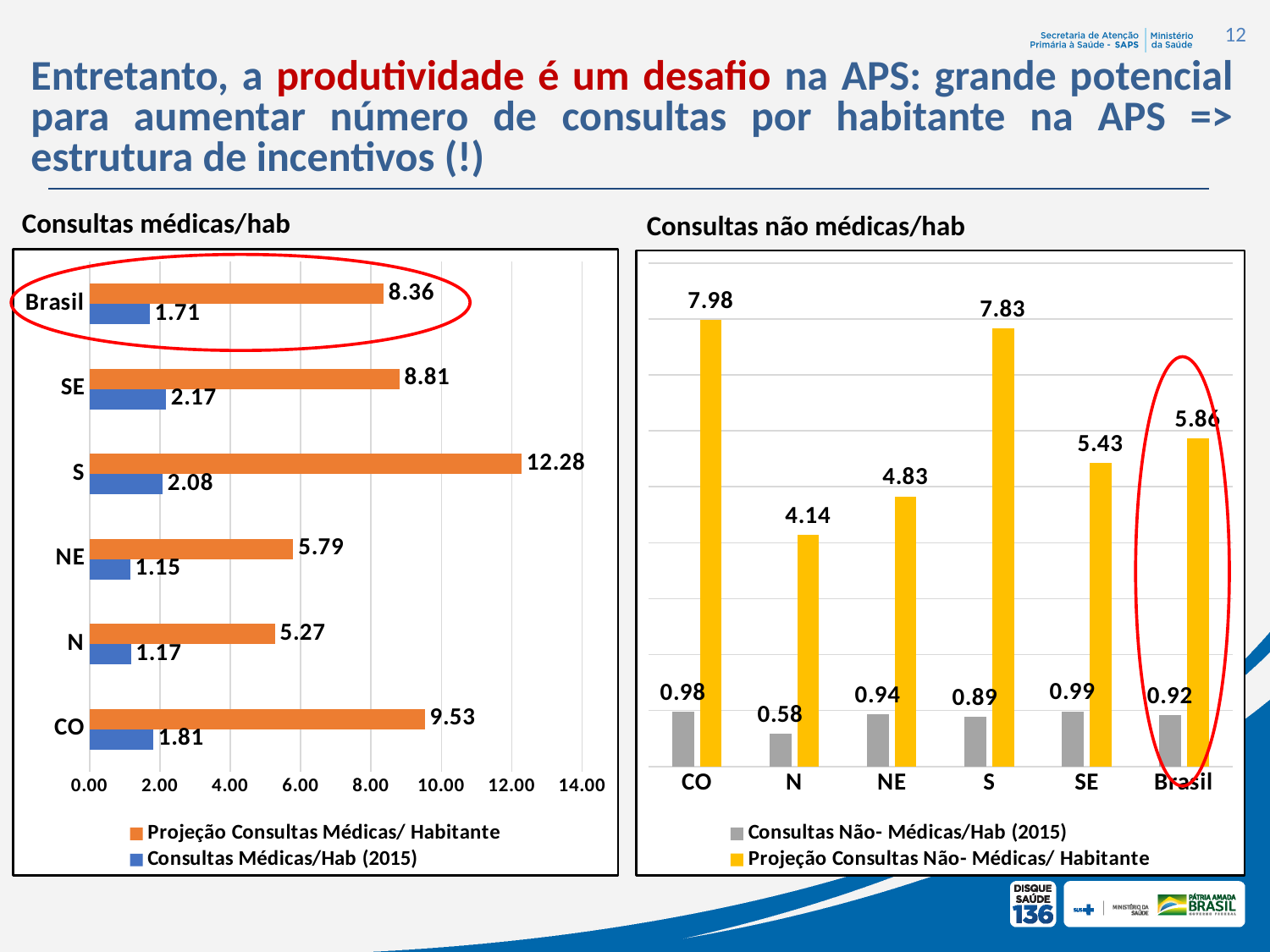
In the 'Consultas médicas/hab' chart, which category has the highest 'Projeção Consultas Médicas/ Habitante' value? S In the 'Consultas médicas/hab' chart, which category has the lowest 'Consultas Médicas/Hab (2015)' value? NE In the 'Consultas médicas/hab' chart, what is the value of 'Consultas Médicas/Hab (2015)' for Brasil? 1.71 In the 'Consultas médicas/hab' chart, what is the value of 'Projeção Consultas Médicas/ Habitante' for S? 12.28 How many categories are shown on the x axis of the 'Consultas não médicas/hab' chart? 6 What type of chart is the 'Consultas médicas/hab' chart? Bar chart How many series does the legend of the 'Consultas não médicas/hab' chart list? 2 In the 'Consultas não médicas/hab' chart, what is the value of 'Projeção Consultas Não- Médicas/ Habitante' for Brasil? 5.86 In the 'Consultas não médicas/hab' chart, which category has the highest 'Projeção Consultas Não- Médicas/ Habitante' value? CO In the 'Consultas não médicas/hab' chart, is the 'Projeção Consultas Não- Médicas/ Habitante' value for S larger than that for SE? Yes, S (7.83) is larger than SE (5.43) In the 'Consultas médicas/hab' chart, what is the difference between the 'Projeção Consultas Médicas/ Habitante' value and the 'Consultas Médicas/Hab (2015)' value for CO? 7.72 In the 'Consultas não médicas/hab' chart, what is the value of 'Consultas Não- Médicas/Hab (2015)' for N? 0.58